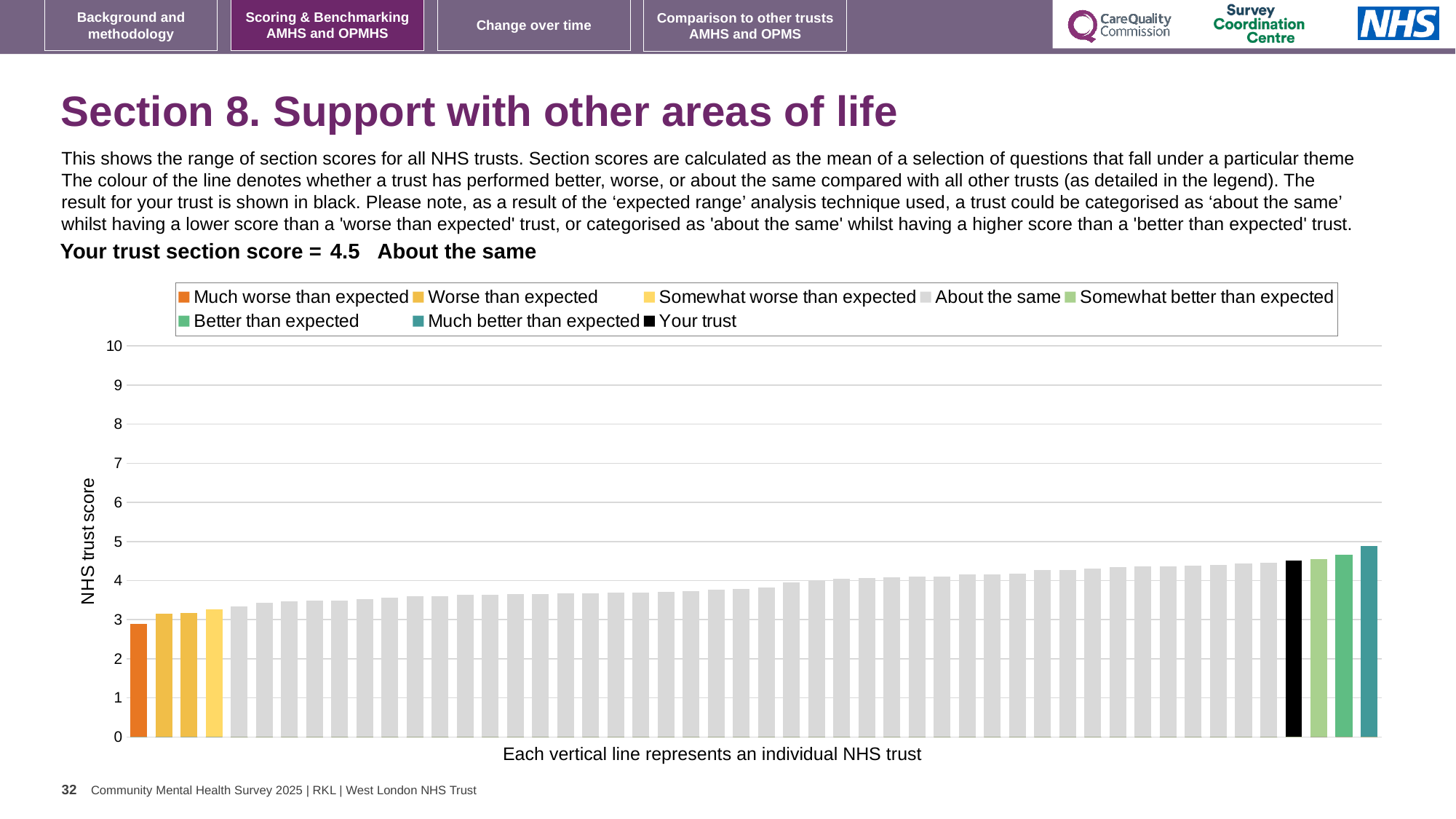
Which legend category does the highest bar on the chart belong to? Much better than expected What kind of chart is shown on the slide? Bar chart How many entries does the chart legend list? 8 Which category does your trust fall into for this section? About the same Is the value of the rightmost (teal) bar greater or less than 5? less Which legend category does the lowest bar on the chart belong to? Much worse than expected Which is larger, the black 'Your trust' bar or the orange 'Much worse than expected' bar? The black 'Your trust' bar What is the section score for your trust shown on the slide? 4.5 What is the label on the vertical axis of the chart? NHS trust score Do the bar values rise or fall from left to right along the x axis? Rise Is the value of the black 'Your trust' bar greater or less than 4? greater Is the value of the leftmost (orange) bar greater or less than 3? less